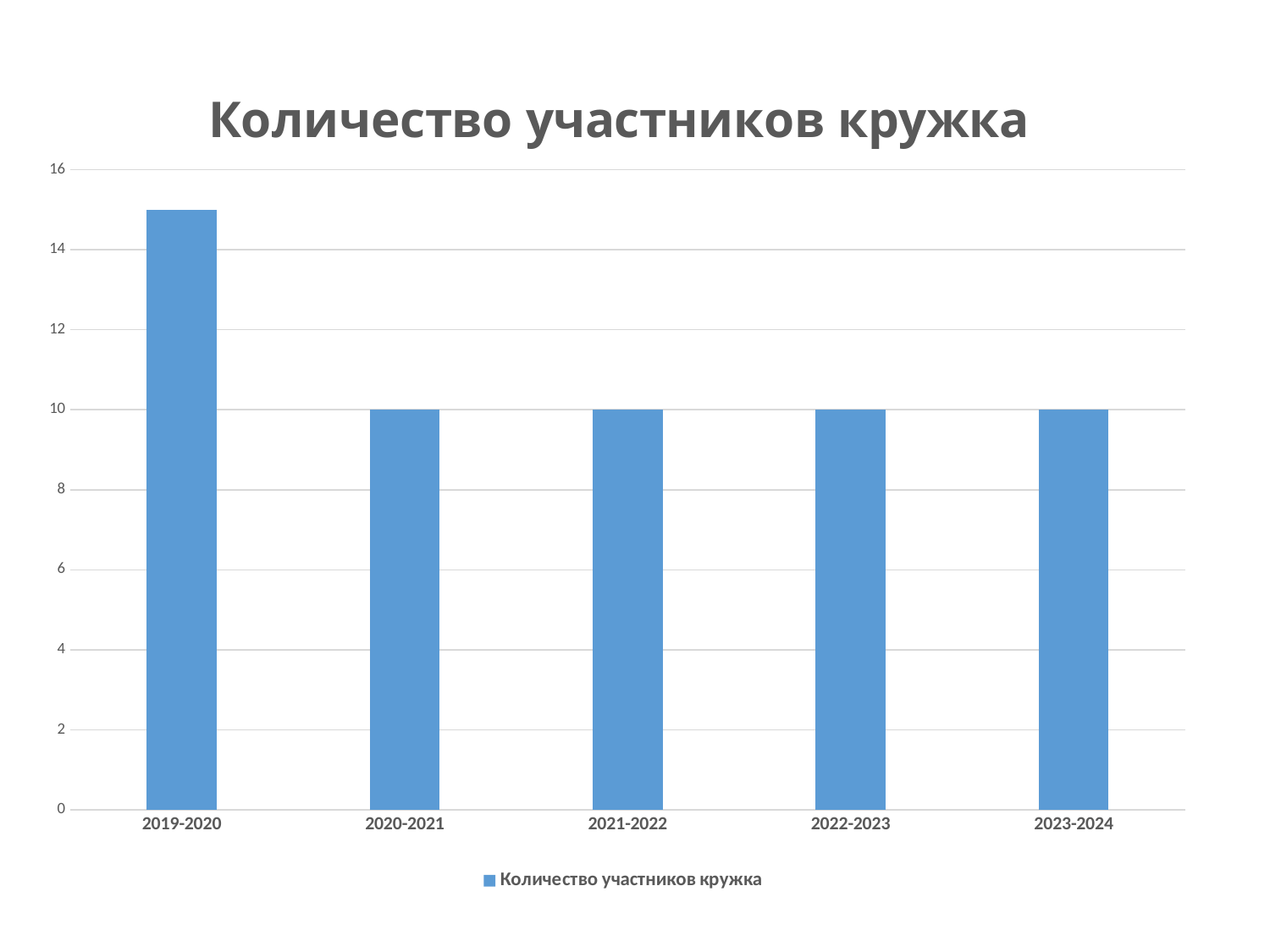
Is the value for 2019-2020 greater or less than 14? greater Which category has the highest value? 2019-2020 What is the value for 2023-2024? 10 Is the value for 2019-2020 greater or less than 16? less What is the value for 2020-2021? 10 Is the value for 2022-2023 greater or less than 12? less Which is larger, the value for 2019-2020 or the value for 2022-2023? 2019-2020 What kind of chart is this? bar chart What is the value for 2021-2022? 10 What is the title of the chart? Количество участников кружка How many categories are shown on the x axis? 5 How many series does the legend list? 1